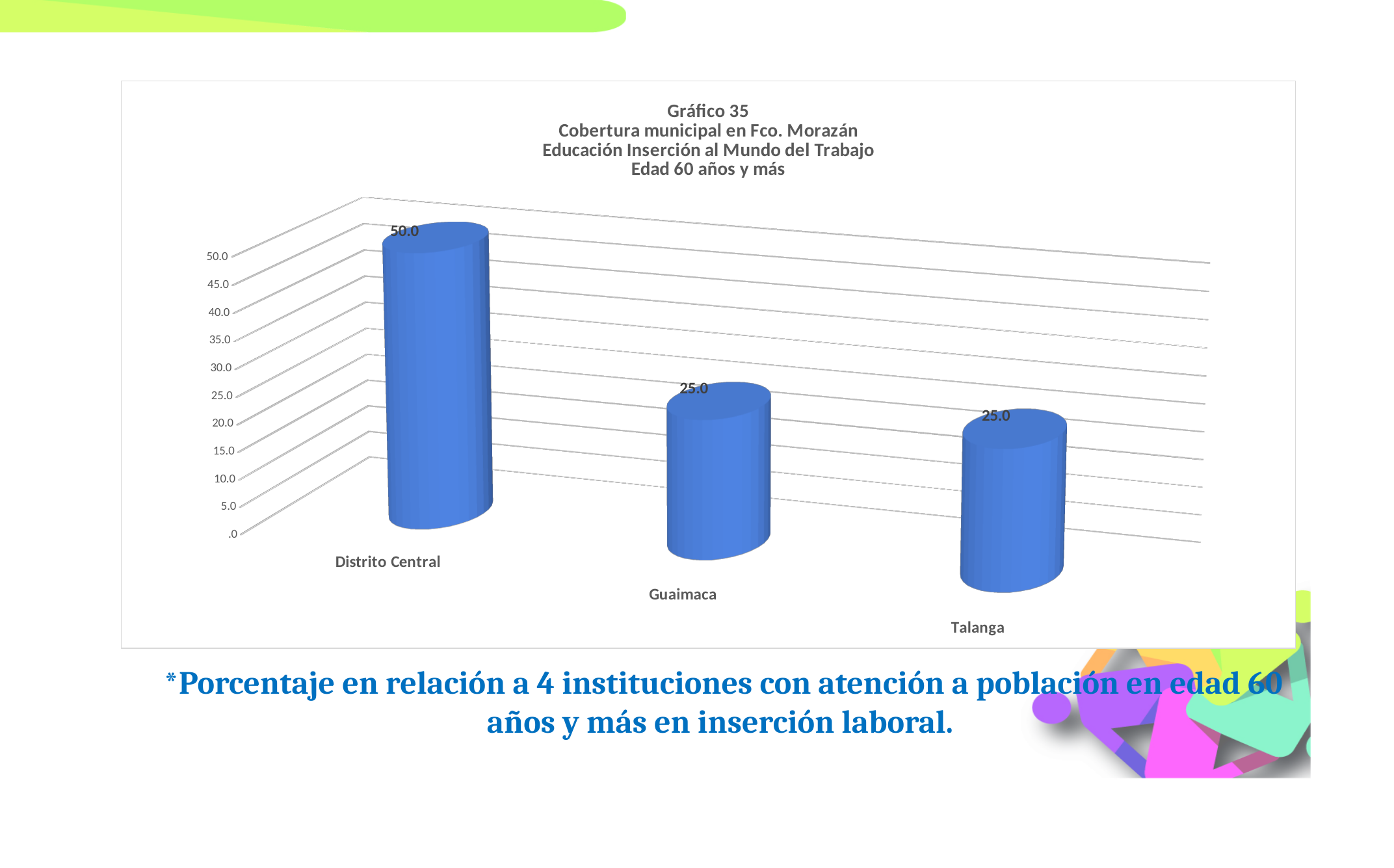
What is the highest value shown on the vertical axis? 50.0 What is the number of the chart given in its title? Gráfico 35 What is the value for Distrito Central? 50.0 What kind of chart is shown on the slide? bar chart Which category has the highest value? Distrito Central Do the values rise or fall from Distrito Central to Guaimaca? fall What is the value for Guaimaca? 25.0 Is the value for Guaimaca greater or less than 40.0? less What is the difference between the values for Distrito Central and Guaimaca? 25.0 Which is larger, the value for Distrito Central or the value for Talanga? Distrito Central What is the value for Talanga? 25.0 How many categories are shown on the x axis? 3